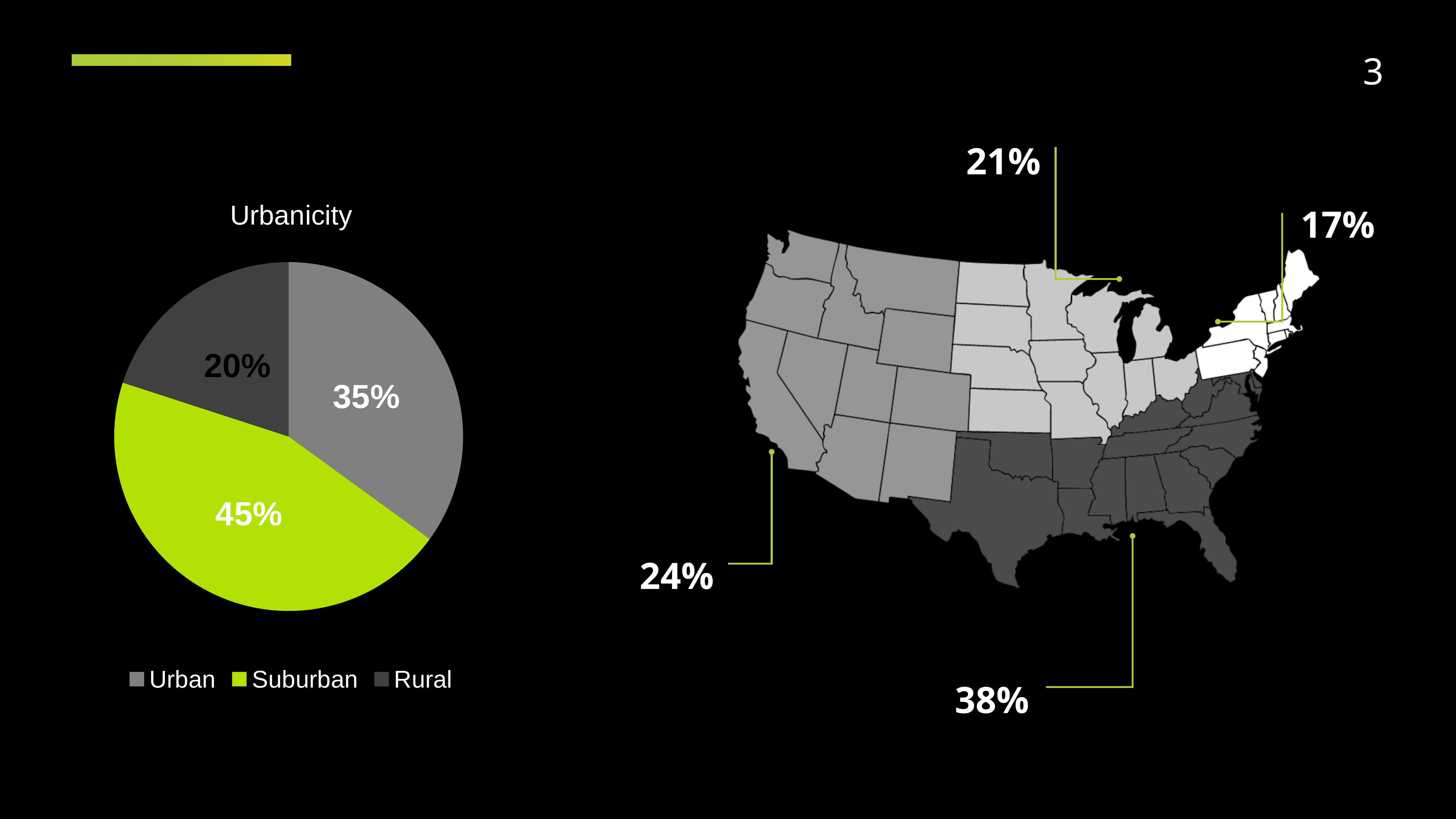
In the Urbanicity pie chart legend, which category is shown in green? Suburban In the Urbanicity pie chart, what is the difference between the Urban and Rural shares? 15% What type of chart is the Urbanicity chart? Pie chart In the Urbanicity pie chart, which category has the smallest share? Rural In the Urbanicity pie chart, what percentage is shown for Rural? 20% How many slices does the Urbanicity pie chart have? 3 In the Urbanicity pie chart, what percentage is shown for Urban? 35% In the Urbanicity pie chart, what is the difference between the Suburban and Urban shares? 10% In the Urbanicity pie chart, which category has the largest share? Suburban In the Urbanicity pie chart, which is larger, Urban or Rural? Urban In the Urbanicity pie chart, what percentage is shown for Suburban? 45% What is the title of the pie chart on the left of the slide? Urbanicity